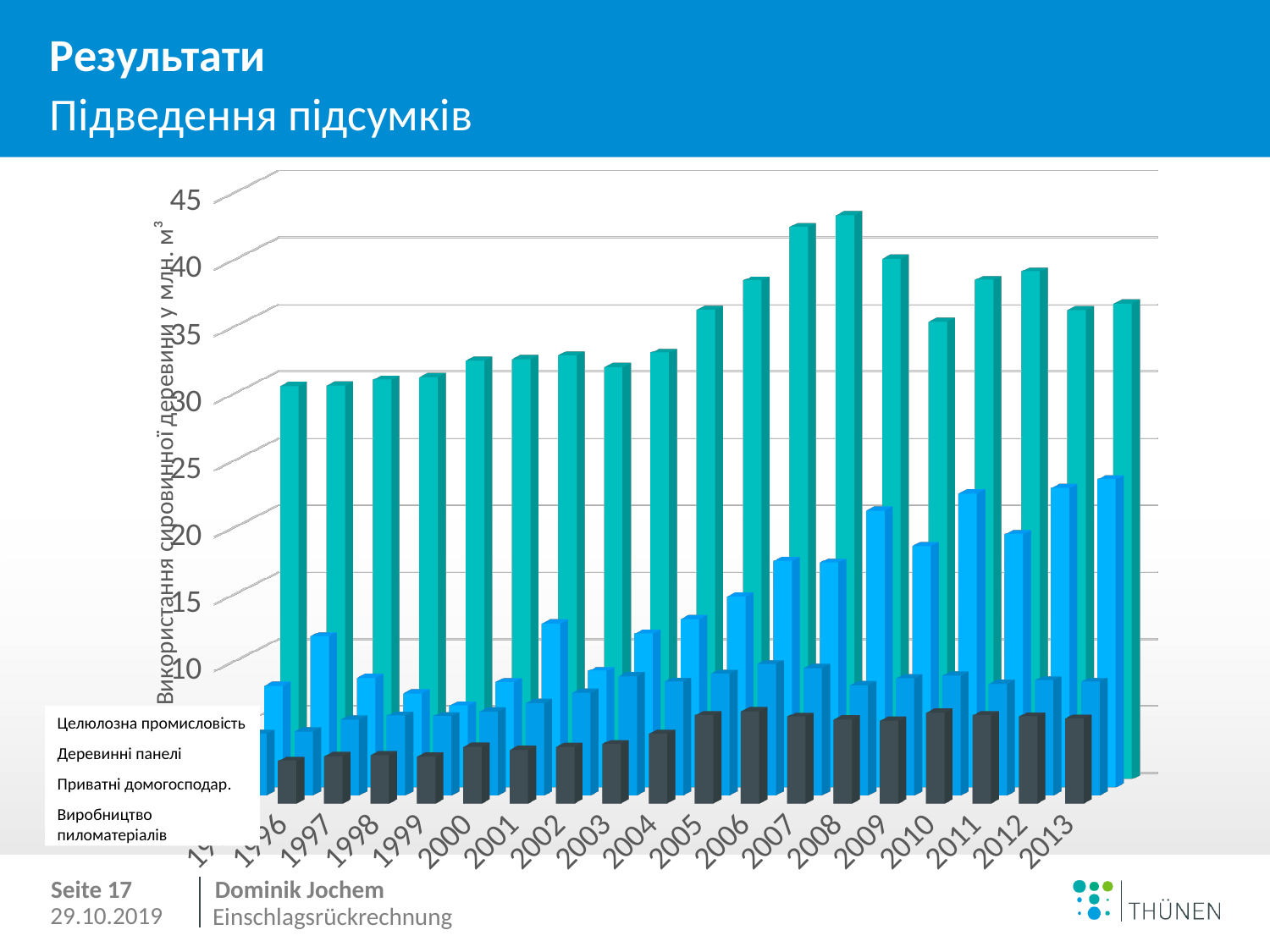
What is the highest tick value shown on the vertical axis? 45 Do the teal bars generally rise or fall from 1996 to 2008? rise In which year is the tallest teal bar the highest? 2007 Is the light blue bar for 2013 greater or less than 20? greater Is the light blue bar for 1996 greater or less than 10? greater Which year has the larger teal bar, 2010 or 2011? 2011 What kind of chart is shown on the slide? bar chart What is the label on the vertical axis of the chart? Використання сировинної деревини у млн. м³ Is the teal bar for 1996 greater or less than 35? less How many series does the legend list? 4 Which year has the larger teal bar, 2007 or 2009? 2007